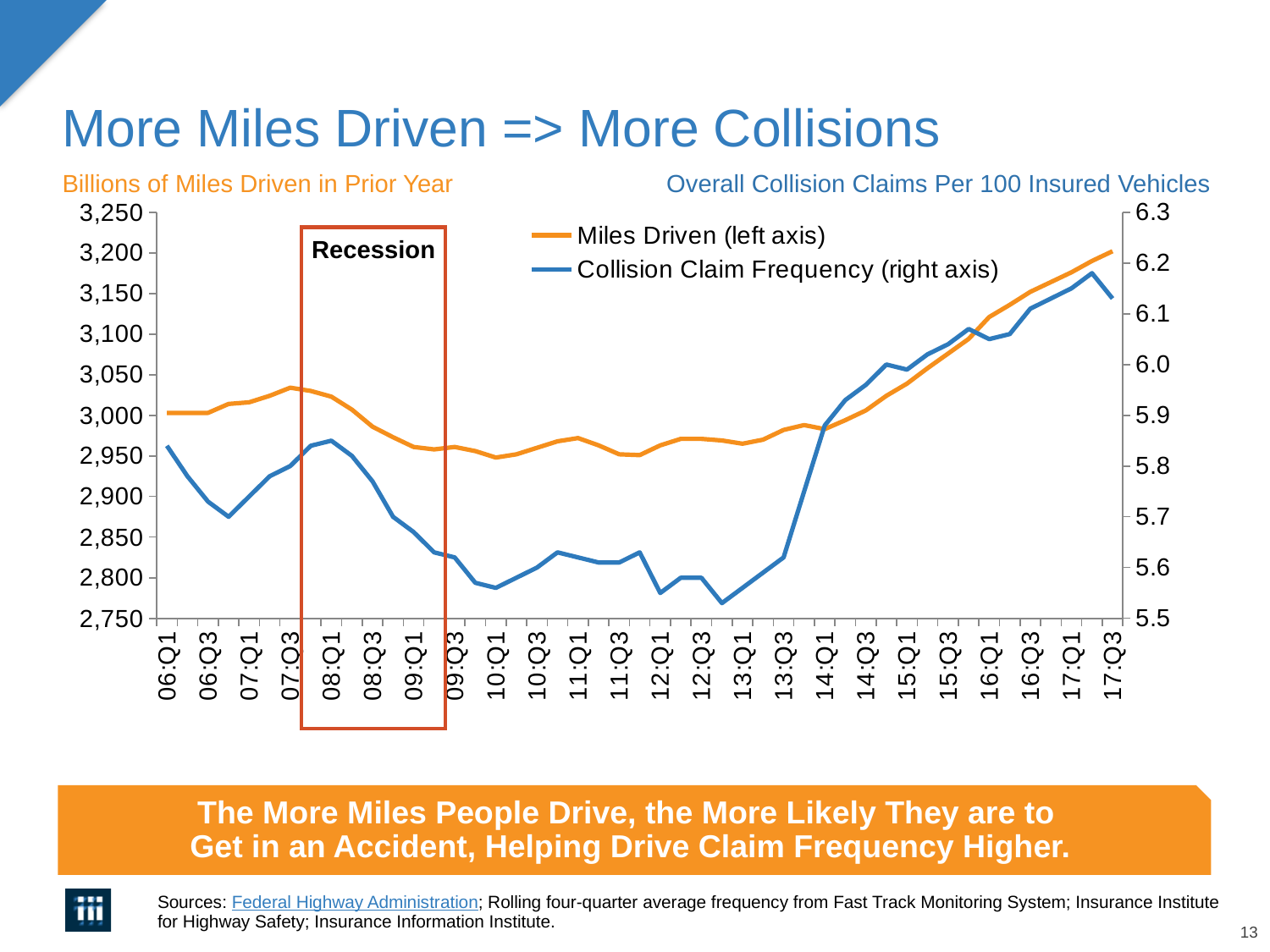
Is the value for Miles Driven at 17:Q3 greater or less than 3,150? greater How many series does the legend list? 2 Does Miles Driven rise or fall from 14:Q1 to 17:Q3? rise What label appears inside the red box on the chart? Recession Is the value for Collision Claim Frequency at 17:Q1 greater or less than 6.1? greater Which series is plotted against the right axis? Collision Claim Frequency Is the value for Collision Claim Frequency at 13:Q1 greater or less than 5.6? less In which quarter does Miles Driven reach its highest value? 17:Q3 How many quarter labels are shown on the x axis? 24 What kind of chart is shown on the slide? line chart